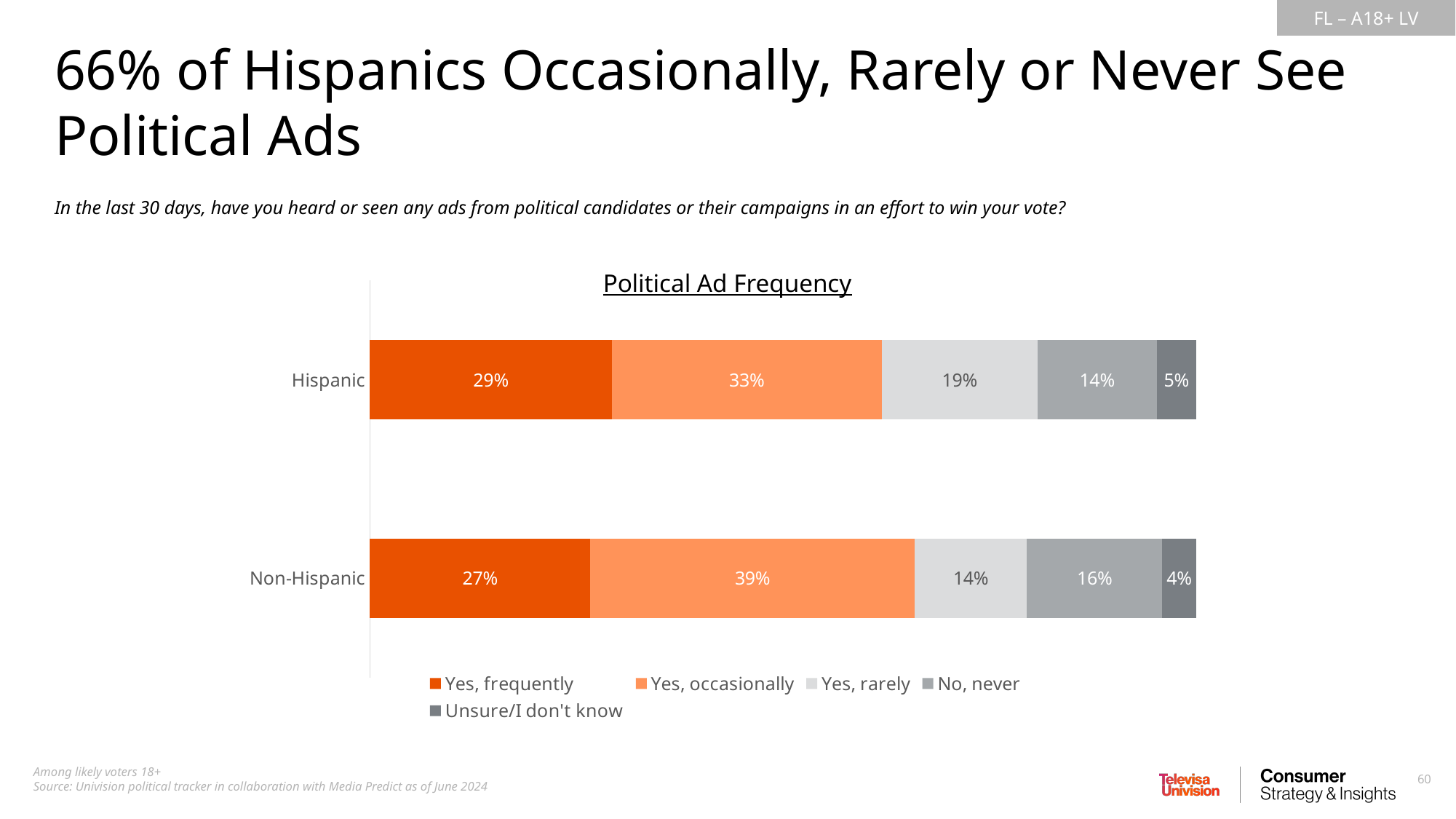
What percentage of Non-Hispanic respondents said they see political ads occasionally? 39% What percentage of Hispanic respondents said they see political ads frequently? 29% What is the 'Yes, rarely' value for Hispanic respondents? 19% What is the 'No, never' value for Non-Hispanic respondents? 16% Which response category has the smallest share among Hispanic respondents? Unsure/I don't know Which response category has the largest share among Non-Hispanic respondents? Yes, occasionally What is the title of the chart? Political Ad Frequency How many series does the legend list? 5 What is the difference between the 'Yes, occasionally' values for Non-Hispanic and Hispanic respondents? 6 percentage points What type of chart is shown on the slide? Stacked bar chart What is the 'Unsure/I don't know' value for Hispanic respondents? 5% Which group has a higher 'Yes, rarely' value, Hispanic or Non-Hispanic? Hispanic